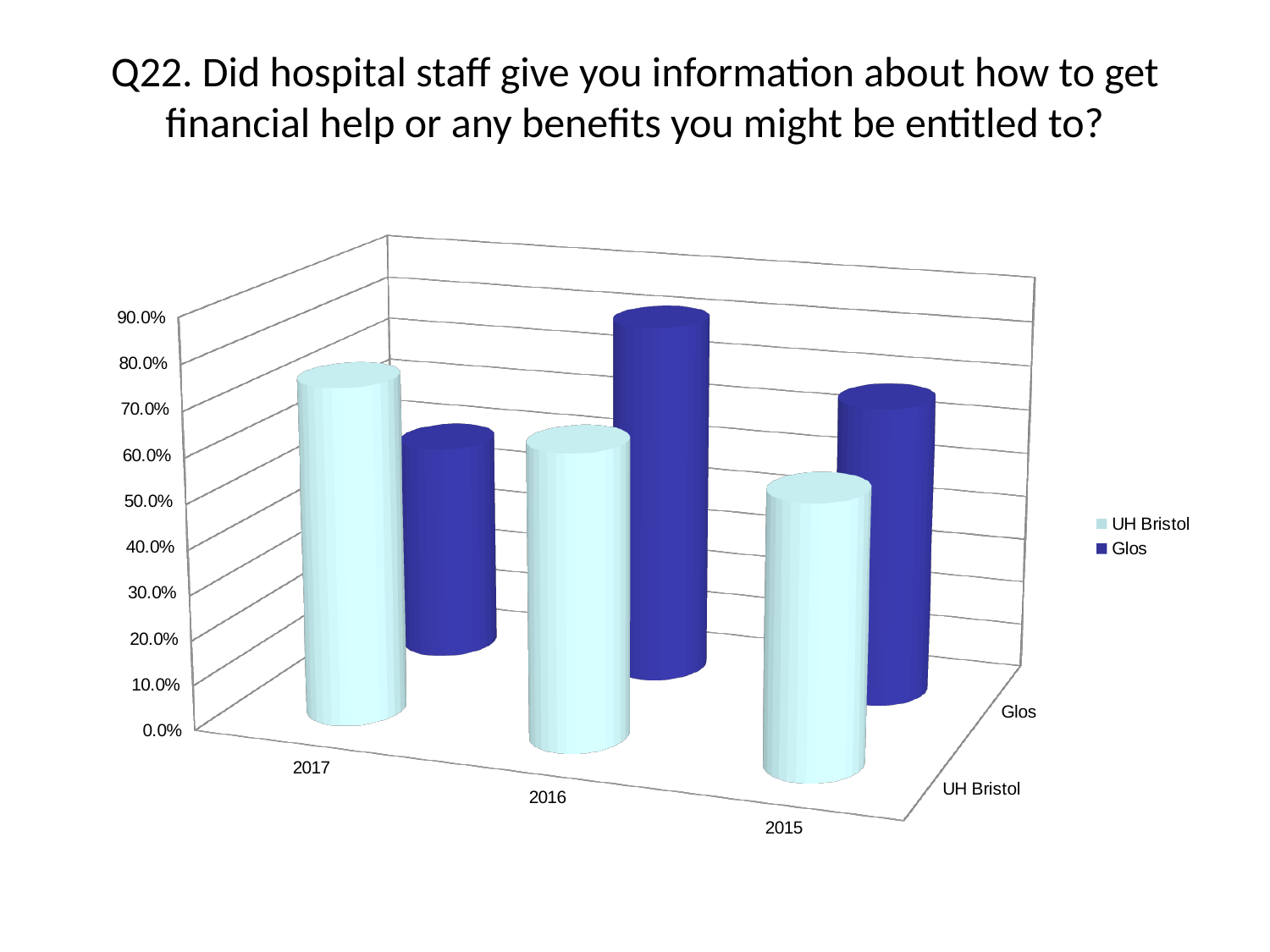
Is the value for Glos in 2017 greater or less than 60.0%? less How many years are shown on the x axis? 3 In 2017, which is larger, UH Bristol or Glos? UH Bristol In 2016, which is larger, UH Bristol or Glos? Glos What kind of chart is shown on the slide? bar chart In which year is the Glos value highest? 2016 Is the value for UH Bristol in 2017 greater or less than 60.0%? greater How many series does the legend list? 2 In which year is the Glos value lowest? 2017 In which year is the UH Bristol value highest? 2017 Which series is shown in dark blue? Glos Is the value for Glos in 2016 greater or less than 60.0%? greater